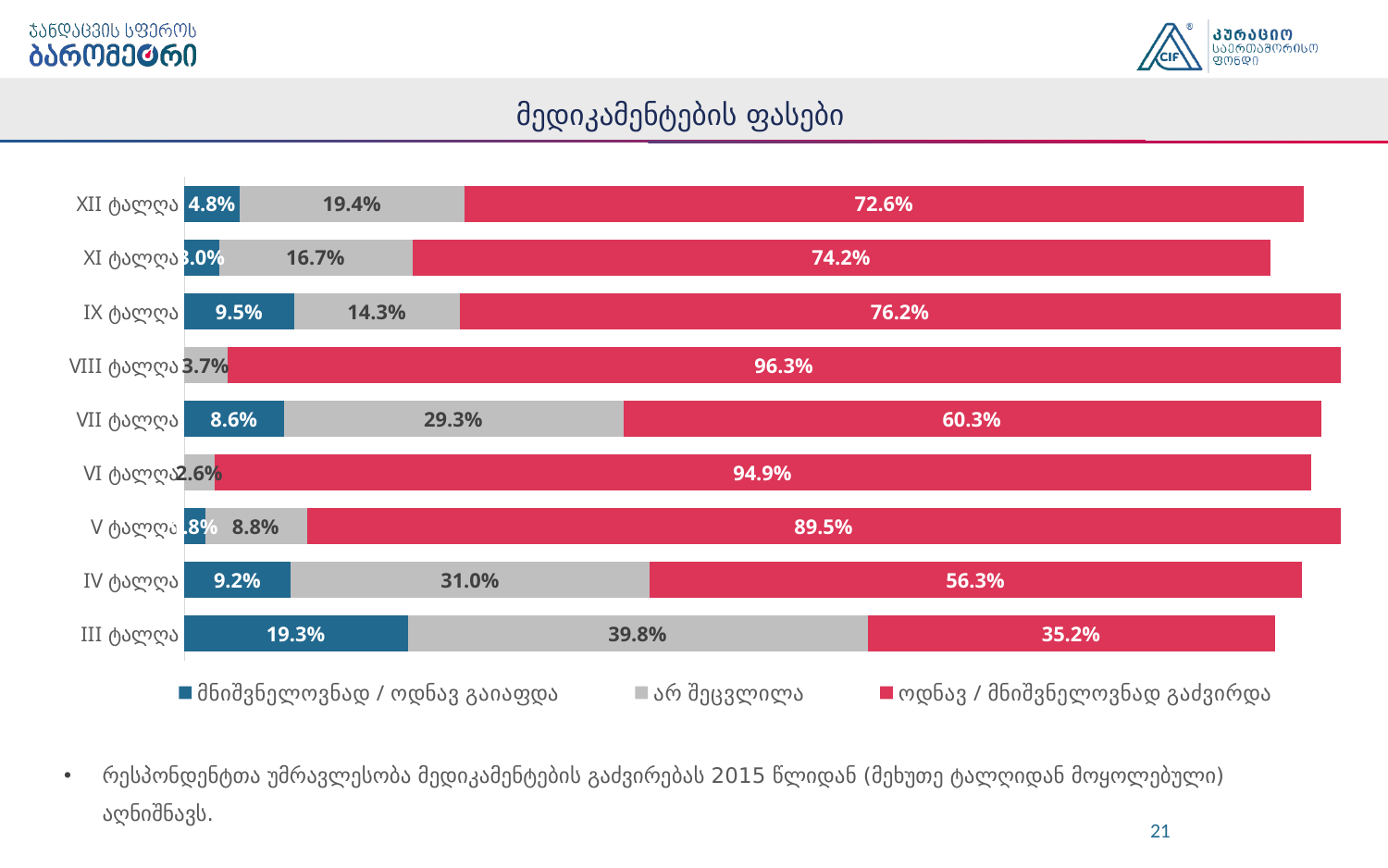
What type of chart is shown on the slide? bar chart How many series does the legend list? 3 Which wave has the lowest value for the red series (ოდნავ / მნიშვნელოვნად გაძვირდა)? III ტალღა What is the title of the chart? მედიკამენტების ფასები Which is larger: the blue series value for IX ტალღა or for IV ტალღა? IX ტალღა What is the value of the gray series (არ შეცვლილა) for IV ტალღა? 31.0% What is the value of the red series (ოდნავ / მნიშვნელოვნად გაძვირდა) for XII ტალღა? 72.6% What is the difference between the red series values for IX ტალღა and VII ტალღა? 15.9% Which wave has the highest value for the gray series (არ შეცვლილა)? III ტალღა How many categories (waves) are shown on the chart? 9 Which wave has the highest value for the red series (ოდნავ / მნიშვნელოვნად გაძვირდა)? VIII ტალღა What is the value of the blue series (მნიშვნელოვნად / ოდნავ გაიაფდა) for III ტალღა? 19.3%